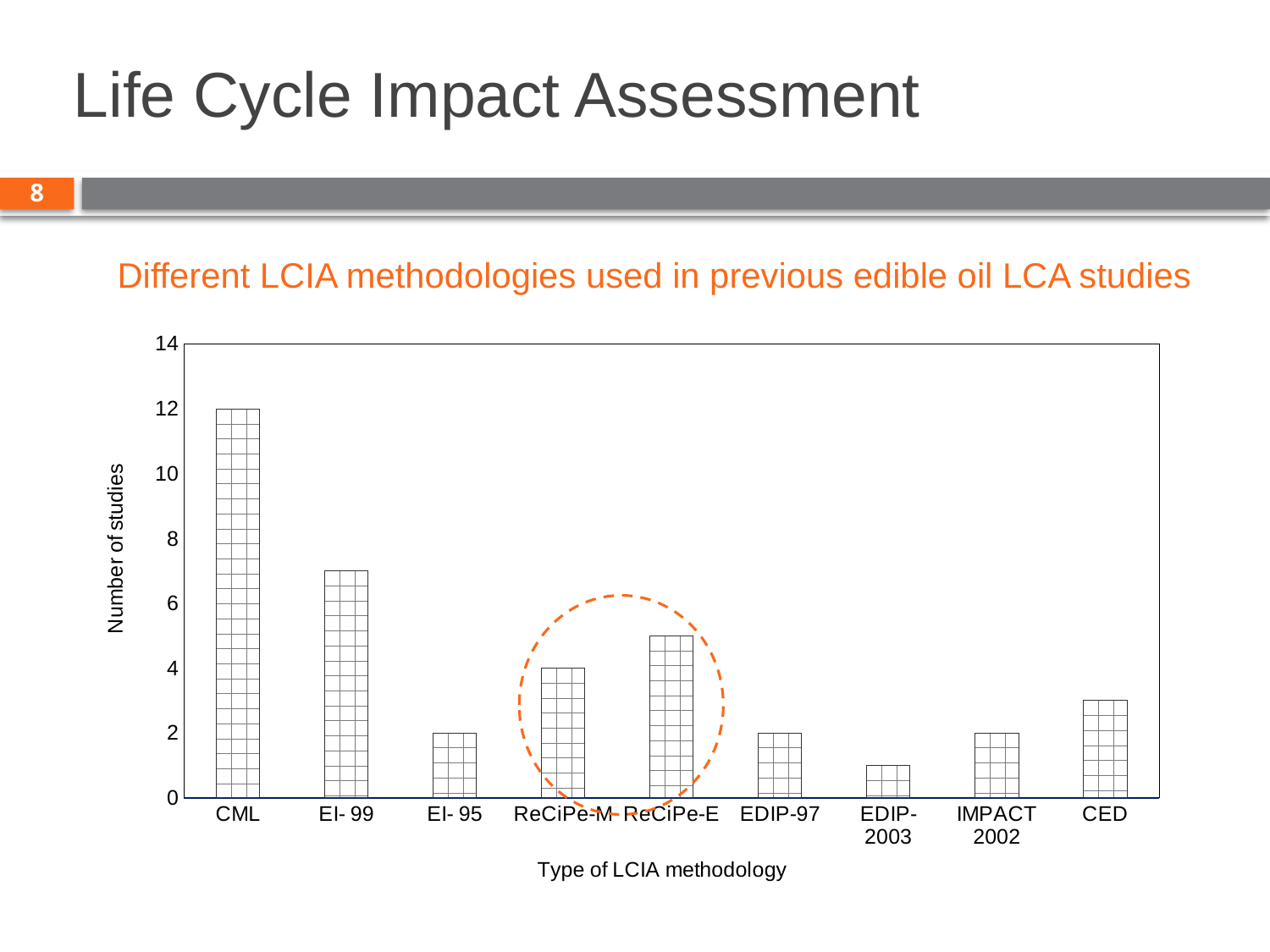
Which has more studies, CML or EI- 99? CML What is the number of studies for ReCiPe-M? 4 What is the number of studies for EI- 95? 2 What is the number of studies for CML? 12 What type of chart is shown on the slide? bar chart Is the value for CED greater or less than 4? less What is the difference in number of studies between CML and ReCiPe-M? 8 Which LCIA methodology has the highest number of studies? CML How many LCIA methodologies are shown on the x axis? 9 Is the value for ReCiPe-E greater or less than 4? greater Which LCIA methodology has the lowest number of studies? EDIP-2003 Is the value for EI- 99 greater or less than 6? greater